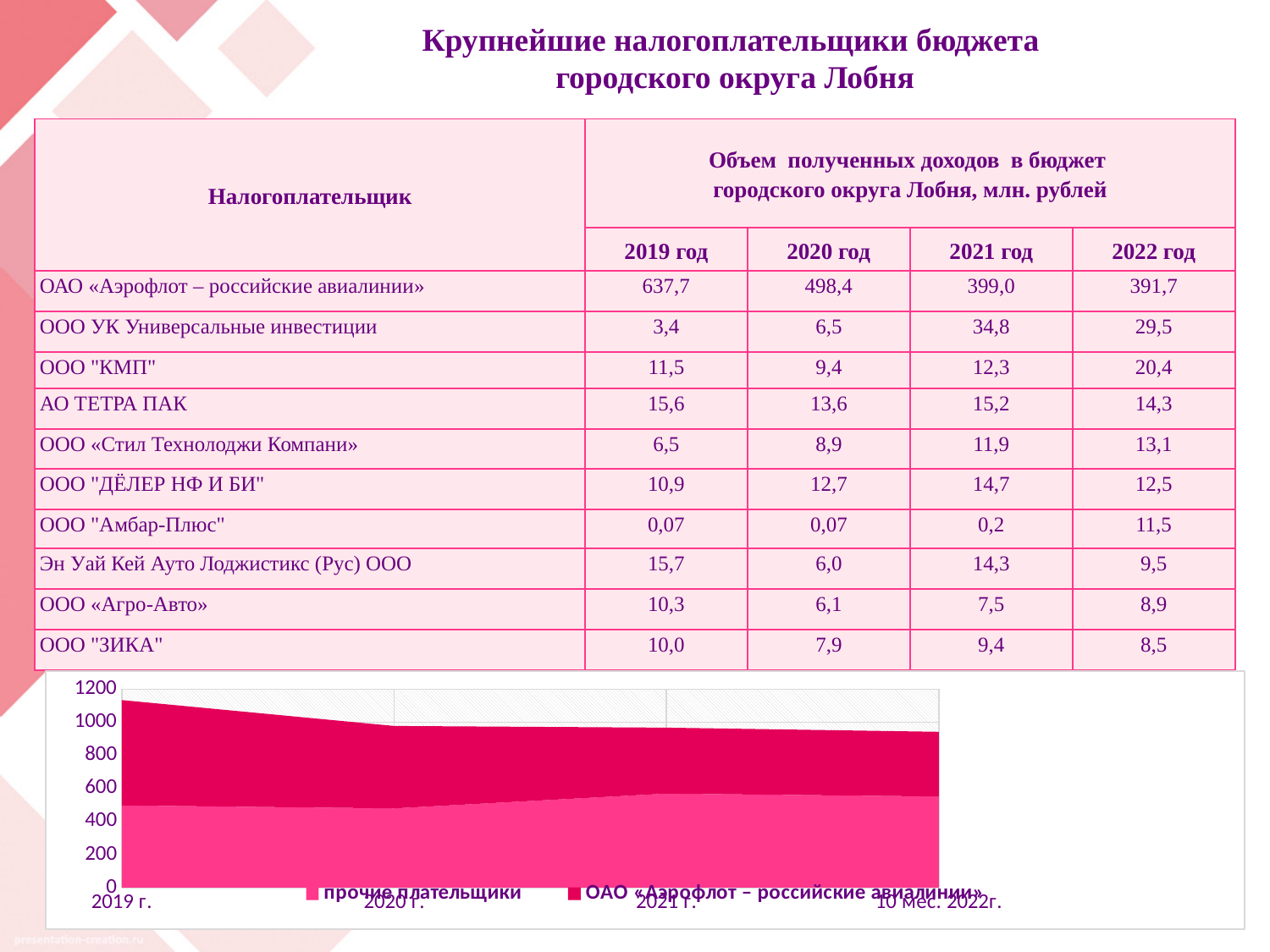
Is the value for прочие плательщики in 2019 г. greater or less than 600? less Does the total stacked value rise or fall from 2019 г. to 10 мес. 2022г.? fall Is the total stacked value for 2019 г. greater or less than 1000? greater Which period has the highest total stacked value in the chart? 2019 г. Is the value for прочие плательщики in 2021 г. greater or less than 400? greater What is the label of the last period on the x axis of the chart? 10 мес. 2022г. How many periods are plotted along the x axis of the chart? 4 How many series does the legend of the chart list? 2 What kind of chart is shown at the bottom of the slide? area chart What are the two series named in the chart legend? прочие плательщики; ОАО «Аэрофлот – российские авиалинии» Which is larger, the total stacked value for 2019 г. or for 2021 г.? 2019 г.